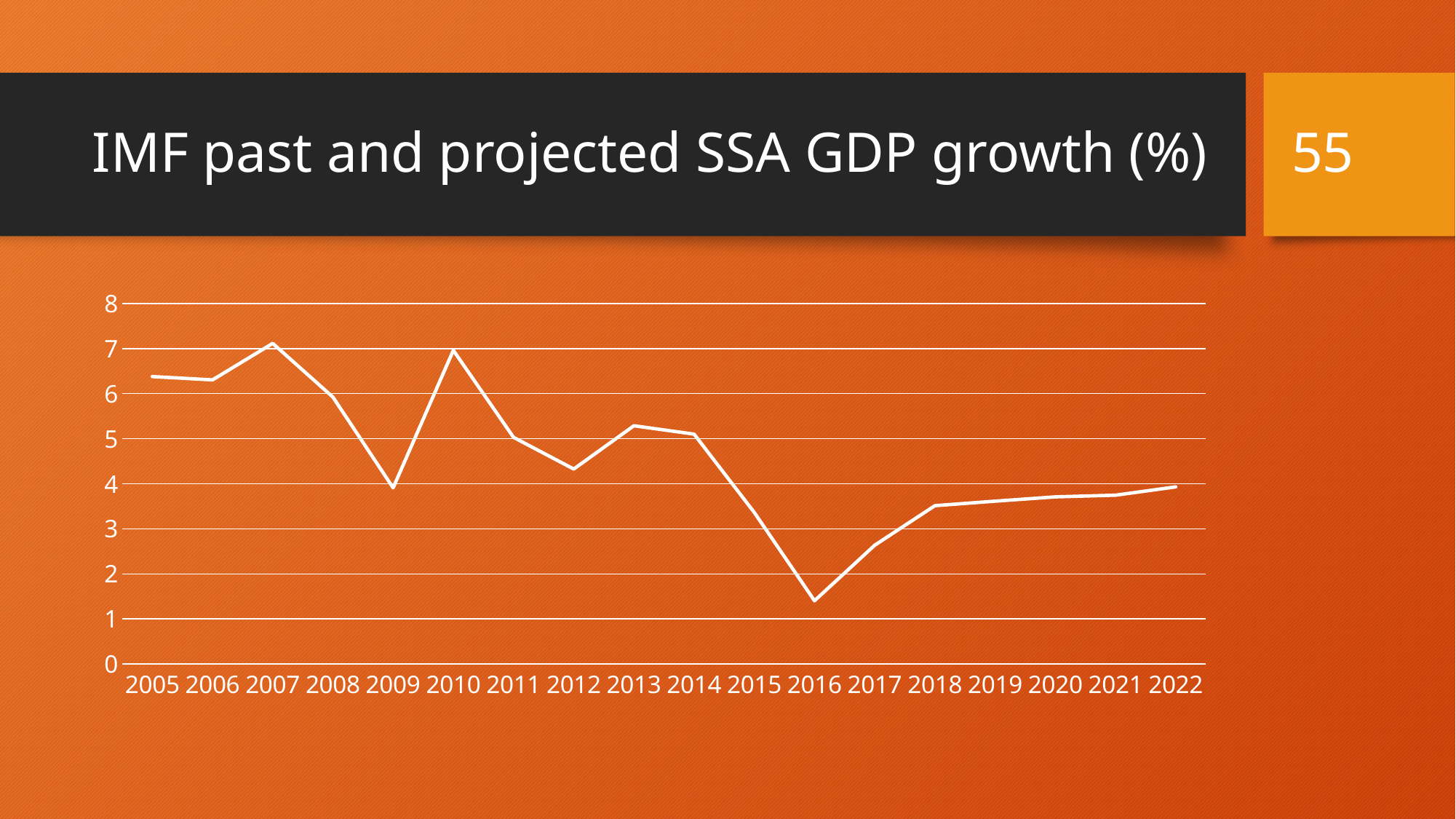
Is the value for 2012 greater or less than 5? less Is the value for 2010 greater or less than 6? greater Which year has the larger value, 2007 or 2009? 2007 Which year has the highest GDP growth value? 2007 Which year has the larger value, 2016 or 2018? 2018 What kind of chart is shown on the slide? line chart What is the title of the chart? IMF past and projected SSA GDP growth (%) How many years are plotted along the x axis? 18 Is the value for 2015 greater or less than 4? less Do the values rise or fall from 2016 to 2022? rise Which year has the lowest GDP growth value? 2016